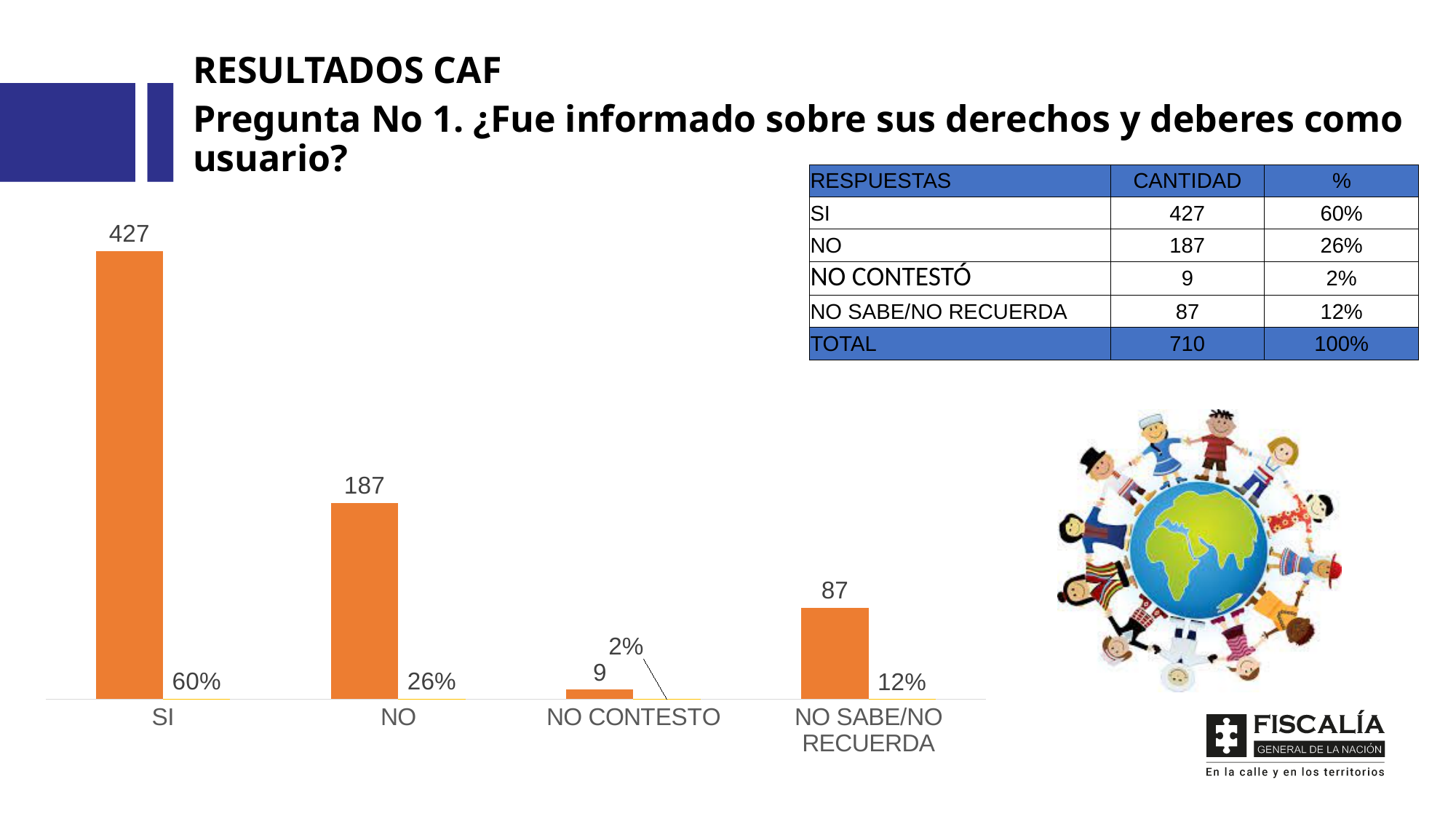
How many categories are shown on the x axis of the chart? 4 What is the value of the bar for NO SABE/NO RECUERDA? 87 What is the value of the bar for NO CONTESTO? 9 What percentage is shown for NO SABE/NO RECUERDA? 12% Which category has the lowest bar? NO CONTESTO Which is larger, the value for NO or the value for NO SABE/NO RECUERDA? NO What is the value of the bar for SI? 427 What kind of chart is shown on the slide? bar chart Which category has the highest bar? SI What is the difference between the values for SI and NO? 240 What colour are the bars showing the counts in the chart? orange What is the value of the bar for NO? 187